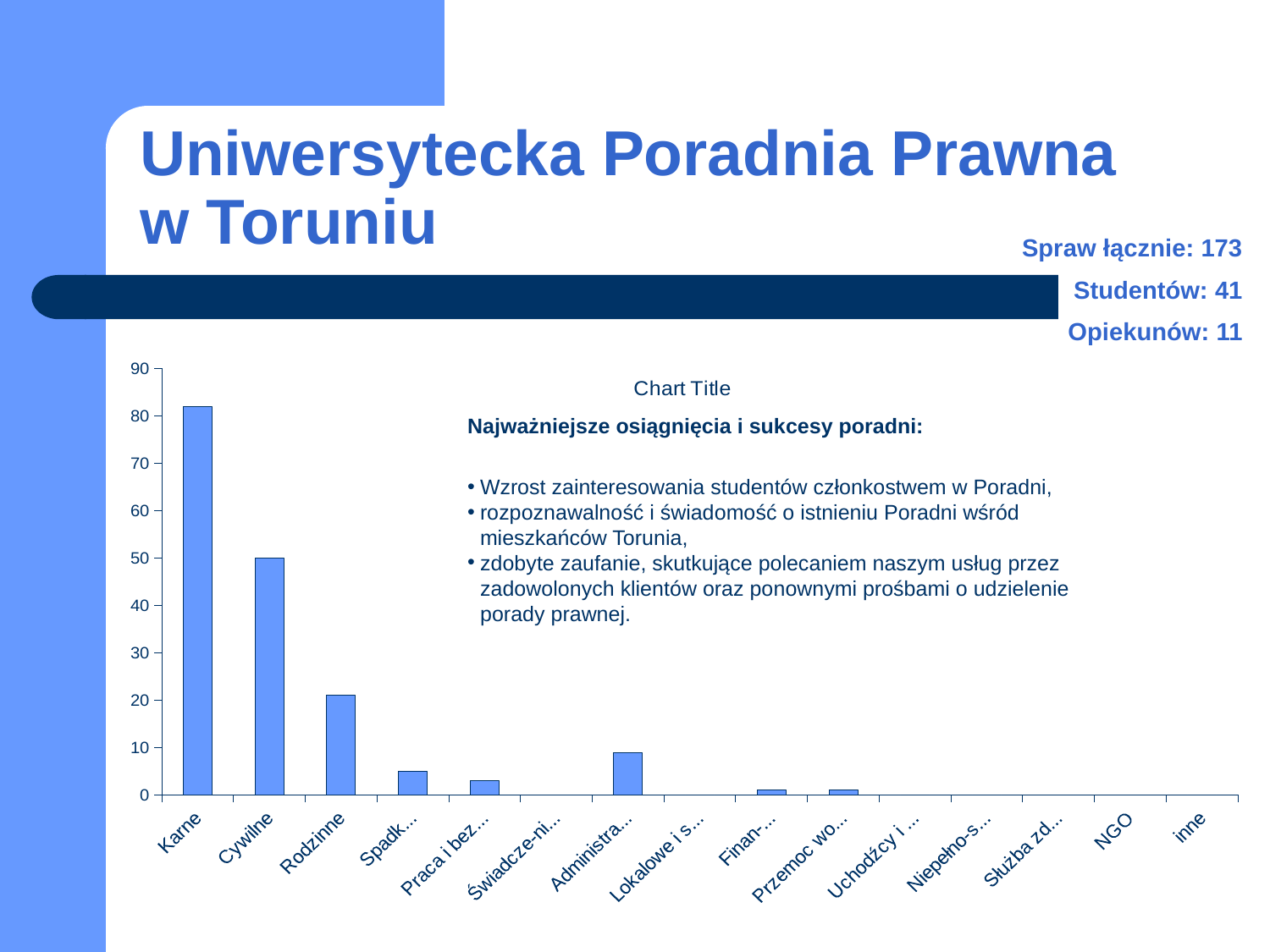
Which is larger, the value for Karne or the value for Cywilne? Karne What kind of chart is shown on the slide? bar chart Which is larger, the value for Rodzinne or the value for Administra...? Rodzinne Is the value for Spadk... greater or less than 10? less What is the value for Cywilne? 50 Is the value for Karne greater or less than 80? greater What is the highest value shown on the vertical axis of the chart? 90 What is the title shown on the chart? Chart Title How many categories are shown on the x axis of the chart? 15 Which category has the highest value in the chart? Karne